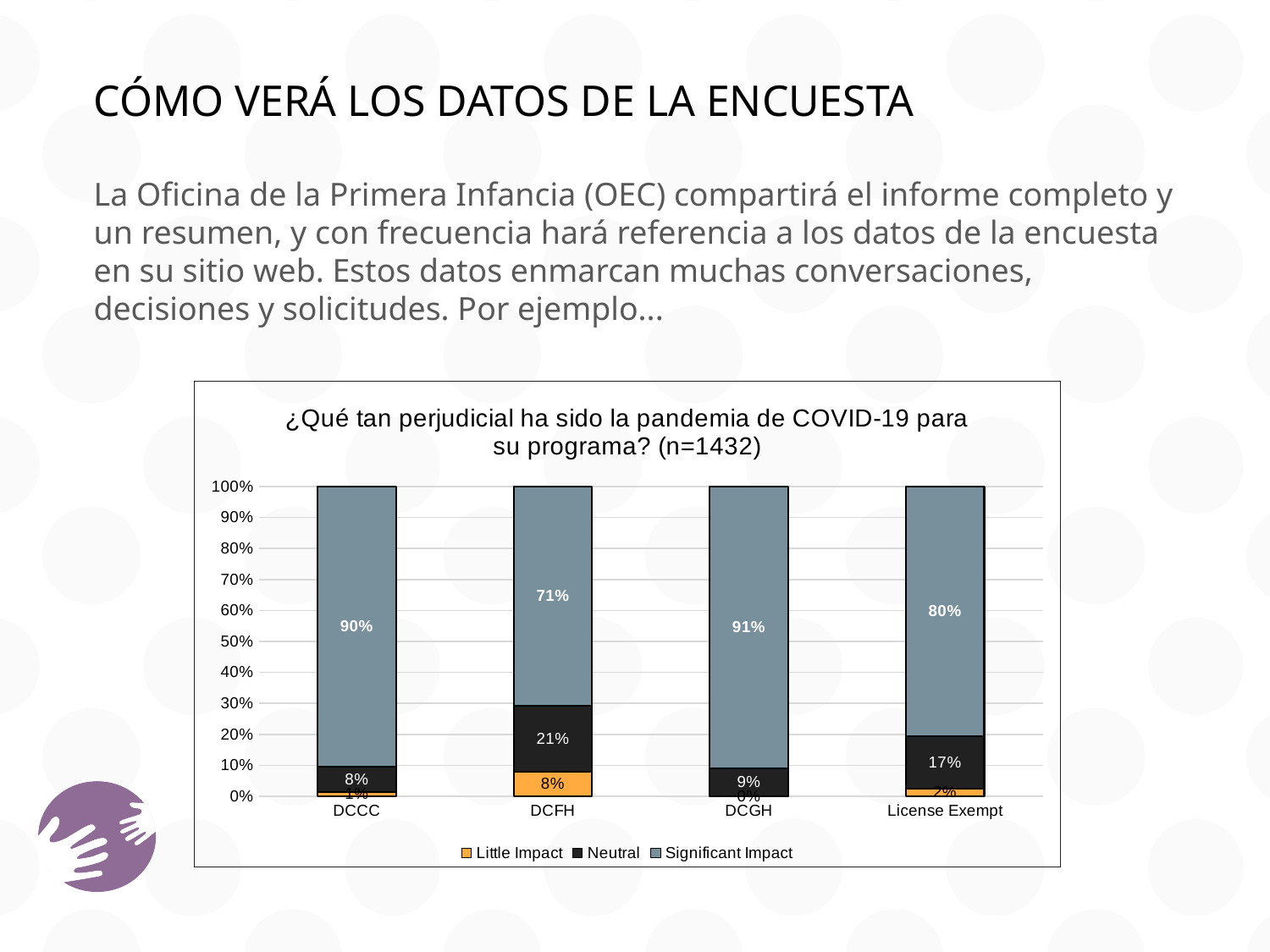
What kind of chart is shown on the slide? Stacked bar chart Which category has the highest Neutral percentage? DCFH Which category has the lowest Significant Impact percentage? DCFH What is the Significant Impact value for DCGH? 91% What is the Little Impact value for DCFH? 8% Which has a larger Significant Impact value, DCCC or License Exempt? DCCC What is the difference between the Neutral values for DCFH and DCCC? 13% Which category has the highest Significant Impact percentage? DCGH How many categories are shown on the x axis? 4 What is the Neutral value for License Exempt? 17% How many series does the legend list? 3 What percentage of DCFH programs reported a Significant Impact? 71%